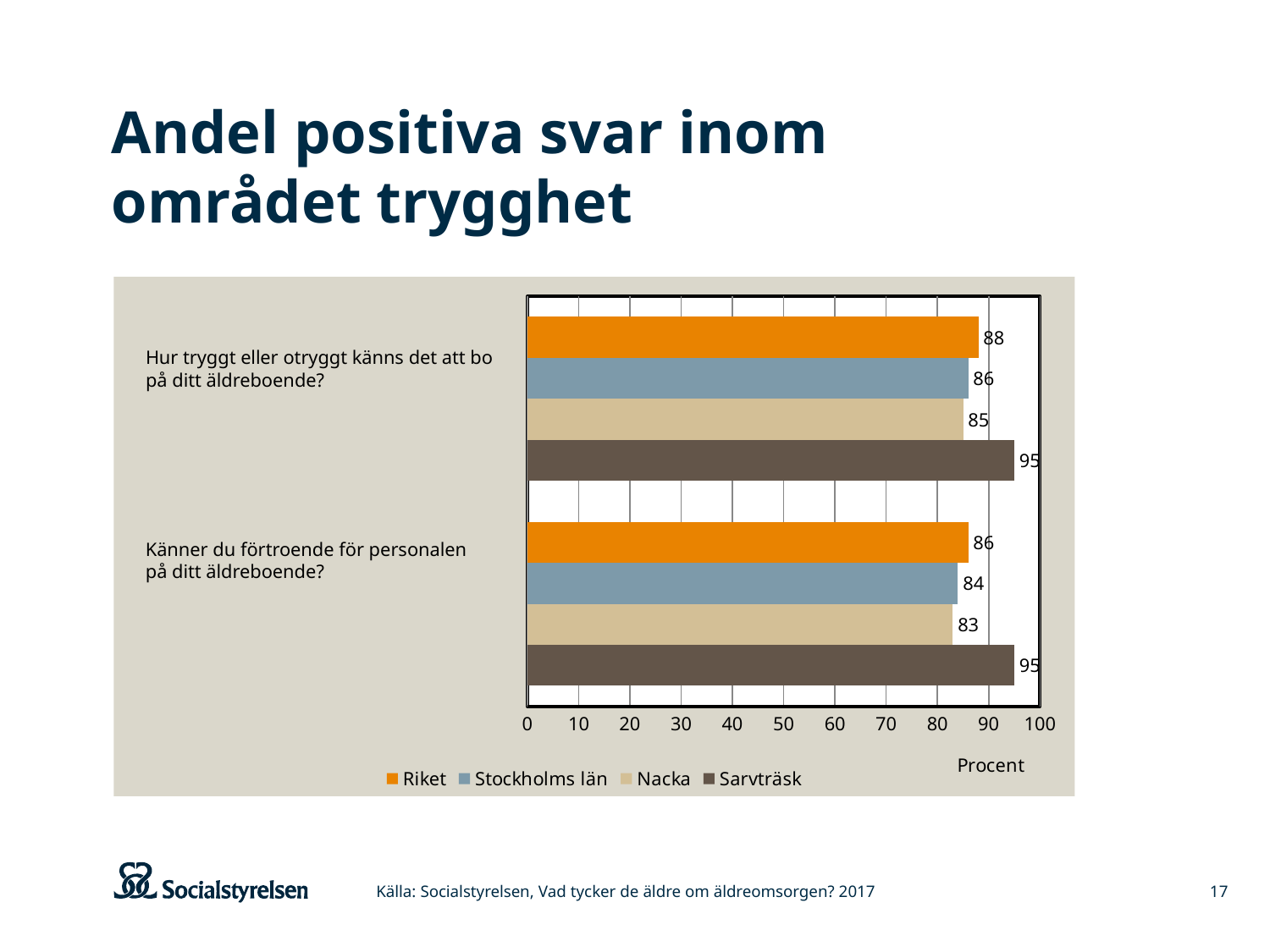
What is the value for Stockholms län for the question 'Känner du förtroende för personalen på ditt äldreboende?' 84 What is the value for Riket for the question 'Känner du förtroende för personalen på ditt äldreboende?' 86 What kind of chart is shown on the slide? bar chart Which series has the highest value for the question 'Känner du förtroende för personalen på ditt äldreboende?' Sarvträsk For the question 'Hur tryggt eller otryggt känns det att bo på ditt äldreboende?', which is larger: the value for Riket or the value for Stockholms län? Riket What unit is shown on the horizontal axis of the chart? Procent What is the difference between the Sarvträsk value and the Nacka value for the question 'Känner du förtroende för personalen på ditt äldreboende?' 12 Is the value for Nacka for the question 'Känner du förtroende för personalen på ditt äldreboende?' greater or less than 90? less Which series has the lowest value for the question 'Hur tryggt eller otryggt känns det att bo på ditt äldreboende?' Nacka What is the value for Sarvträsk for the question 'Hur tryggt eller otryggt känns det att bo på ditt äldreboende?' 95 How many series does the legend list? 4 What is the value for Nacka for the question 'Hur tryggt eller otryggt känns det att bo på ditt äldreboende?' 85